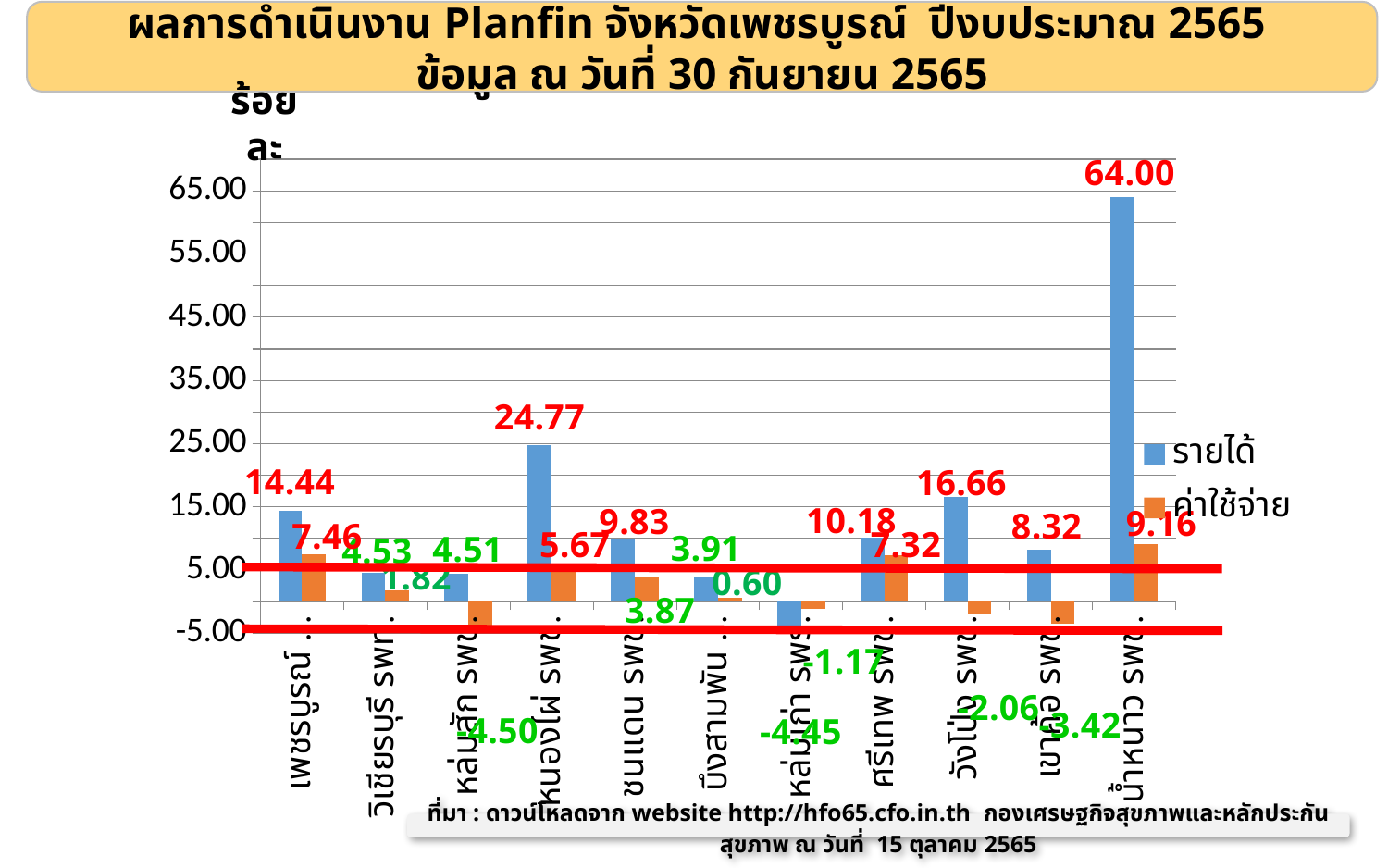
Which category has the highest รายได้ value? น้ำหนาว รพช. What is the รายได้ value for น้ำหนาว รพช.? 64.00 What is the รายได้ value for หนองไผ่ รพช.? 24.77 Is the รายได้ value for น้ำหนาว รพช. greater or less than 55.00? greater Which is larger, the รายได้ value for วังโป่ง รพช. or the รายได้ value for เพชรบูรณ์? วังโป่ง รพช. What is the ค่าใช้จ่าย value for เพชรบูรณ์? 7.46 What is the difference between the รายได้ and ค่าใช้จ่าย values for ศรีเทพ รพช.? 2.86 What kind of chart is shown on the slide? bar chart How many categories are shown on the x axis? 11 Which category has the lowest รายได้ value? หล่มเก่า รพร. How many series does the legend list? 2 What is the ค่าใช้จ่าย value for หล่มสัก รพช.? -4.50